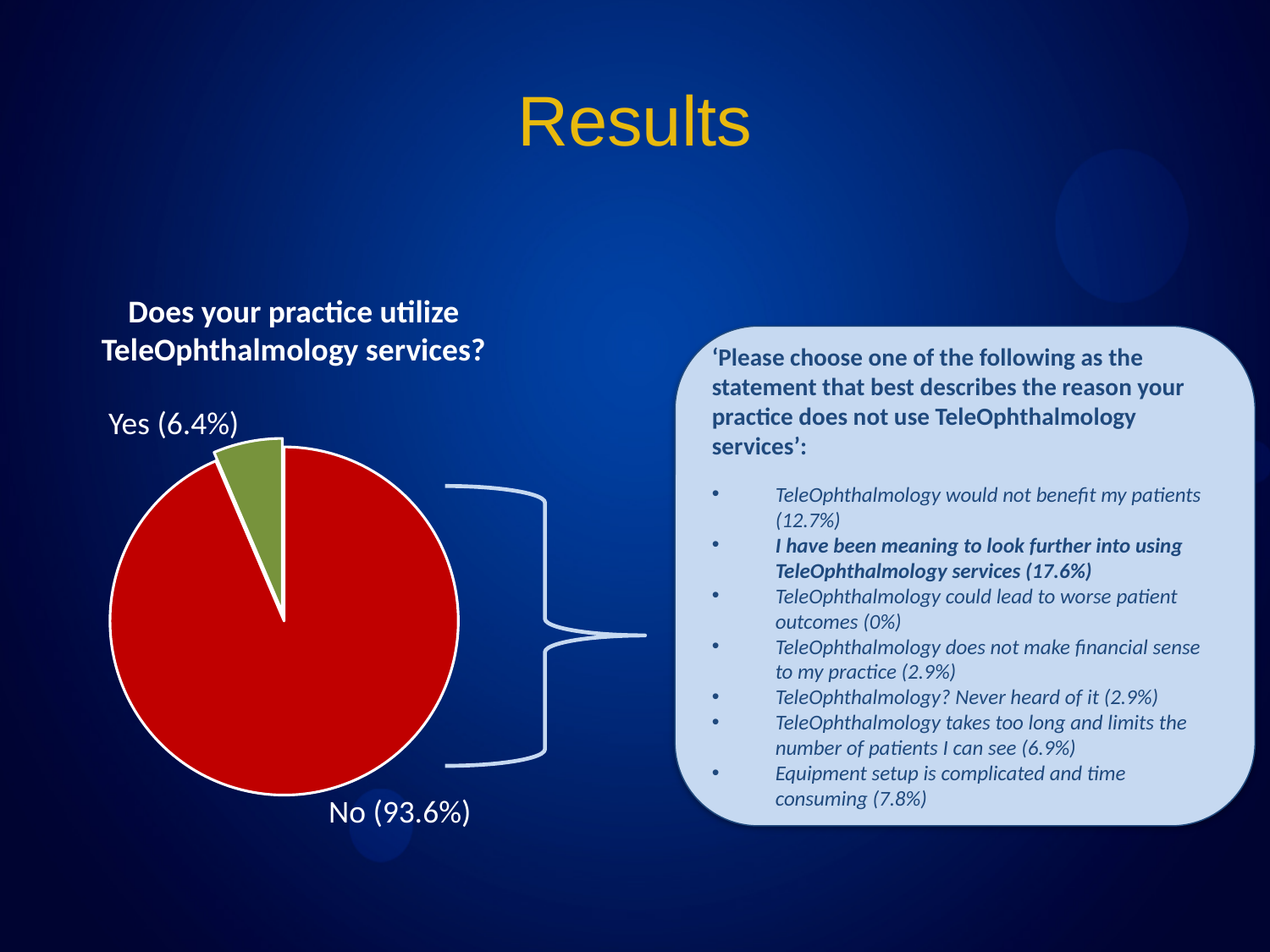
What colour is the "No" slice of the pie chart? red Which category has the smallest slice of the pie? Yes What percentage of practices answered "Yes" to utilizing TeleOphthalmology services? 6.4% What kind of chart is shown on the slide? pie chart What question does the pie chart answer, according to its title? Does your practice utilize TeleOphthalmology services? How many slices does the pie chart have? 2 What is the difference in percentage points between the No and Yes slices? 87.2 Which response has the larger share of the pie, Yes or No? No What percentage of practices answered "No" to utilizing TeleOphthalmology services? 93.6% Which category has the largest slice of the pie? No